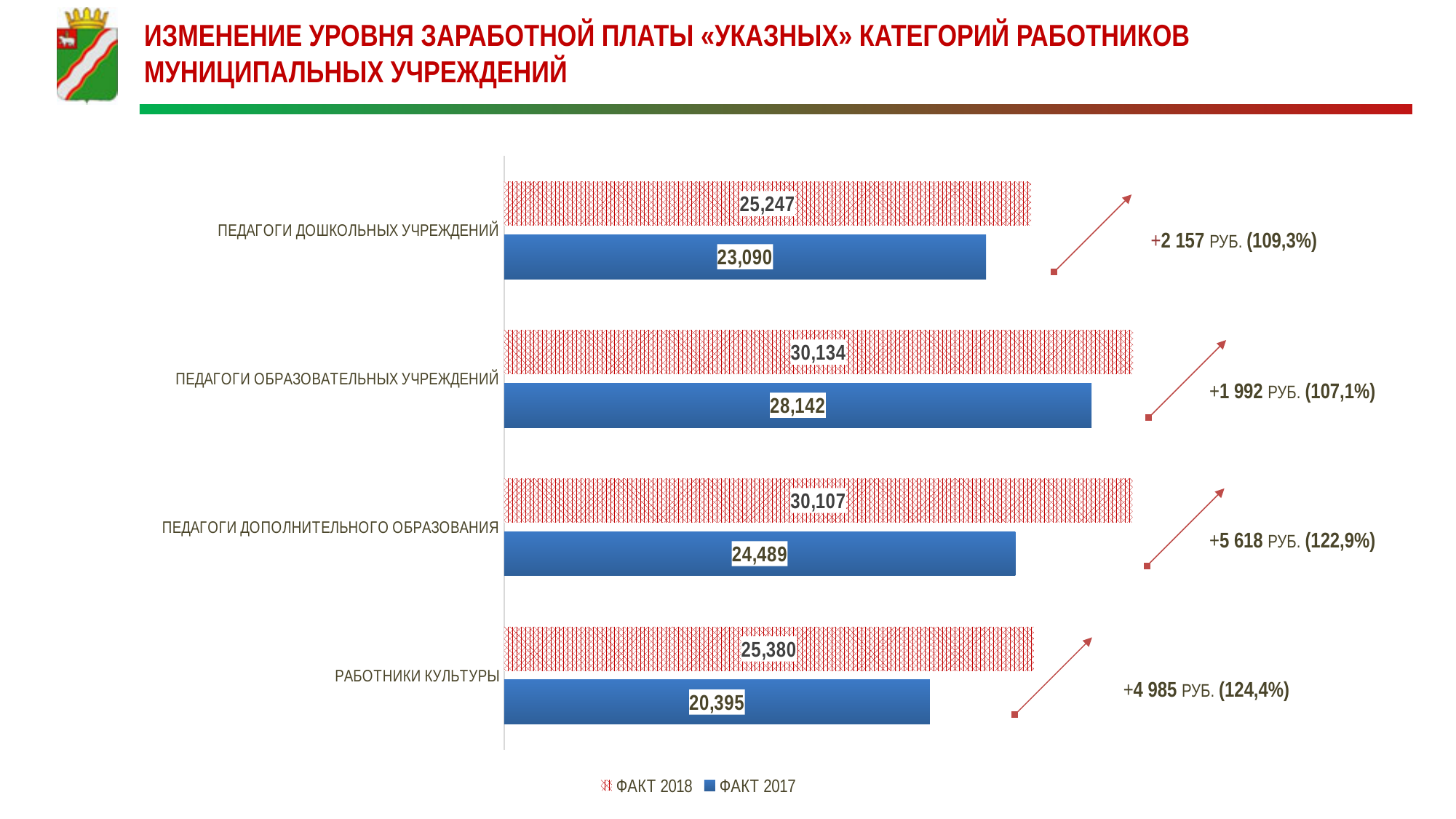
What is the ФАКТ 2018 value for ПЕДАГОГИ ДОШКОЛЬНЫХ УЧРЕЖДЕНИЙ? 25,247 What is the ФАКТ 2017 value for РАБОТНИКИ КУЛЬТУРЫ? 20,395 What kind of chart is shown on the slide? Bar chart How many categories are shown in the chart? 4 For РАБОТНИКИ КУЛЬТУРЫ, which is larger: the ФАКТ 2018 value or the ФАКТ 2017 value? ФАКТ 2018 What is the difference between the ФАКТ 2018 and ФАКТ 2017 values for ПЕДАГОГИ ДОПОЛНИТЕЛЬНОГО ОБРАЗОВАНИЯ? 5,618 What is the ФАКТ 2018 value for ПЕДАГОГИ ОБРАЗОВАТЕЛЬНЫХ УЧРЕЖДЕНИЙ? 30,134 How many series does the legend list? 2 What increase is annotated next to the bars for РАБОТНИКИ КУЛЬТУРЫ? +4 985 РУБ. (124,4%) Which category has the lowest ФАКТ 2017 value? РАБОТНИКИ КУЛЬТУРЫ Which category has the highest ФАКТ 2017 value? ПЕДАГОГИ ОБРАЗОВАТЕЛЬНЫХ УЧРЕЖДЕНИЙ What is the ФАКТ 2017 value for ПЕДАГОГИ ДОПОЛНИТЕЛЬНОГО ОБРАЗОВАНИЯ? 24,489